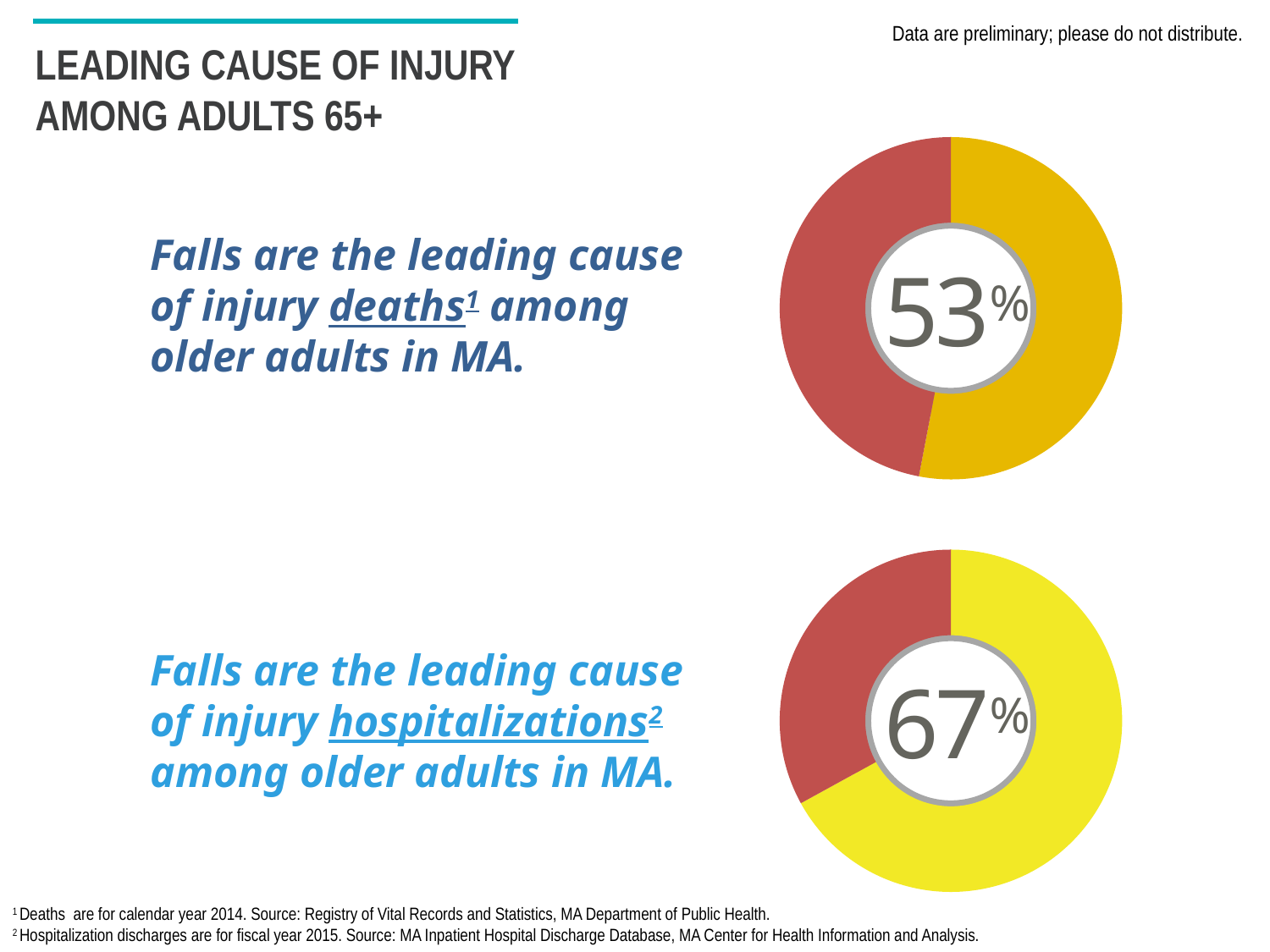
What is the difference between the percentage in the bottom chart and the percentage in the top chart? 14 percentage points How many segments does each donut chart have? 2 In the top chart, what percentage is printed in the centre? 53% Based on the top chart, what share of injury deaths among older adults in MA are not due to falls? 47% According to the bottom chart, what share of injury hospitalizations among older adults in MA are due to falls? 67% What kind of chart is used on this slide to show the percentages? pie chart (donut) Which chart shows the larger percentage, the top chart (injury deaths) or the bottom chart (injury hospitalizations)? the bottom chart (injury hospitalizations) How many charts are shown on the slide? 2 What colour is the larger segment in the bottom chart? yellow In the bottom chart, what percentage is printed in the centre? 67% According to the top chart, what share of injury deaths among older adults in MA are due to falls? 53% Is the percentage shown in the top chart greater or less than 50%? greater